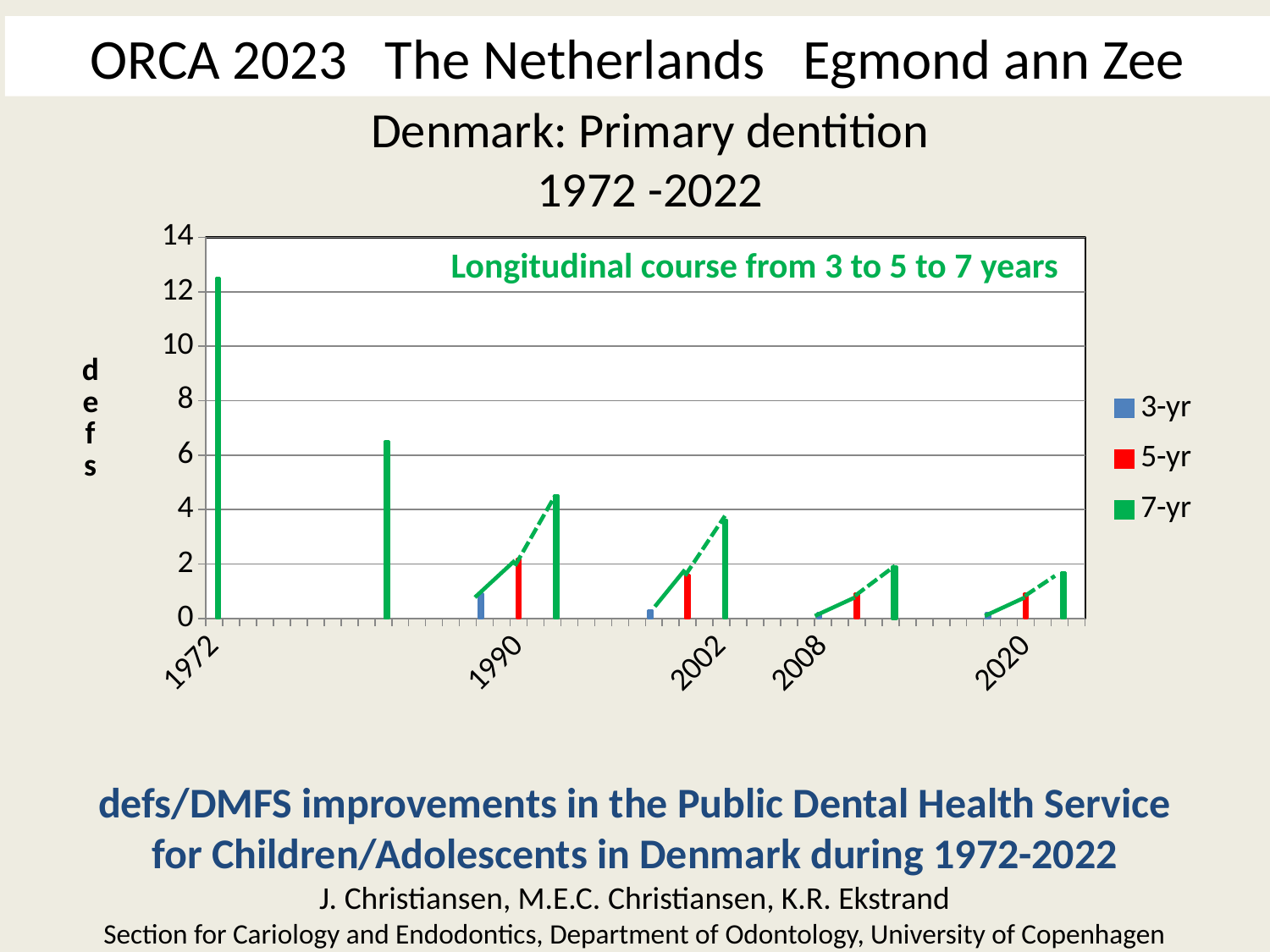
Is the value of the 7-yr bar near 2020 greater or less than 2? less Is the value of the 7-yr bar near 2002 greater or less than 4? less How many series does the chart legend list? 3 What is the label on the vertical axis of the chart? defs Is the value of the 3-yr bar at 1990 greater or less than 2? less What kind of chart is shown on the slide? bar chart Do the 7-yr values rise or fall from 1972 to 2020 along the x axis? fall Which year label on the x axis has the tallest bar in the chart? 1972 Which is larger, the 7-yr bar at 1972 or the 7-yr bar near 2002? the 7-yr bar at 1972 What are the three series named in the chart legend? 3-yr, 5-yr, 7-yr